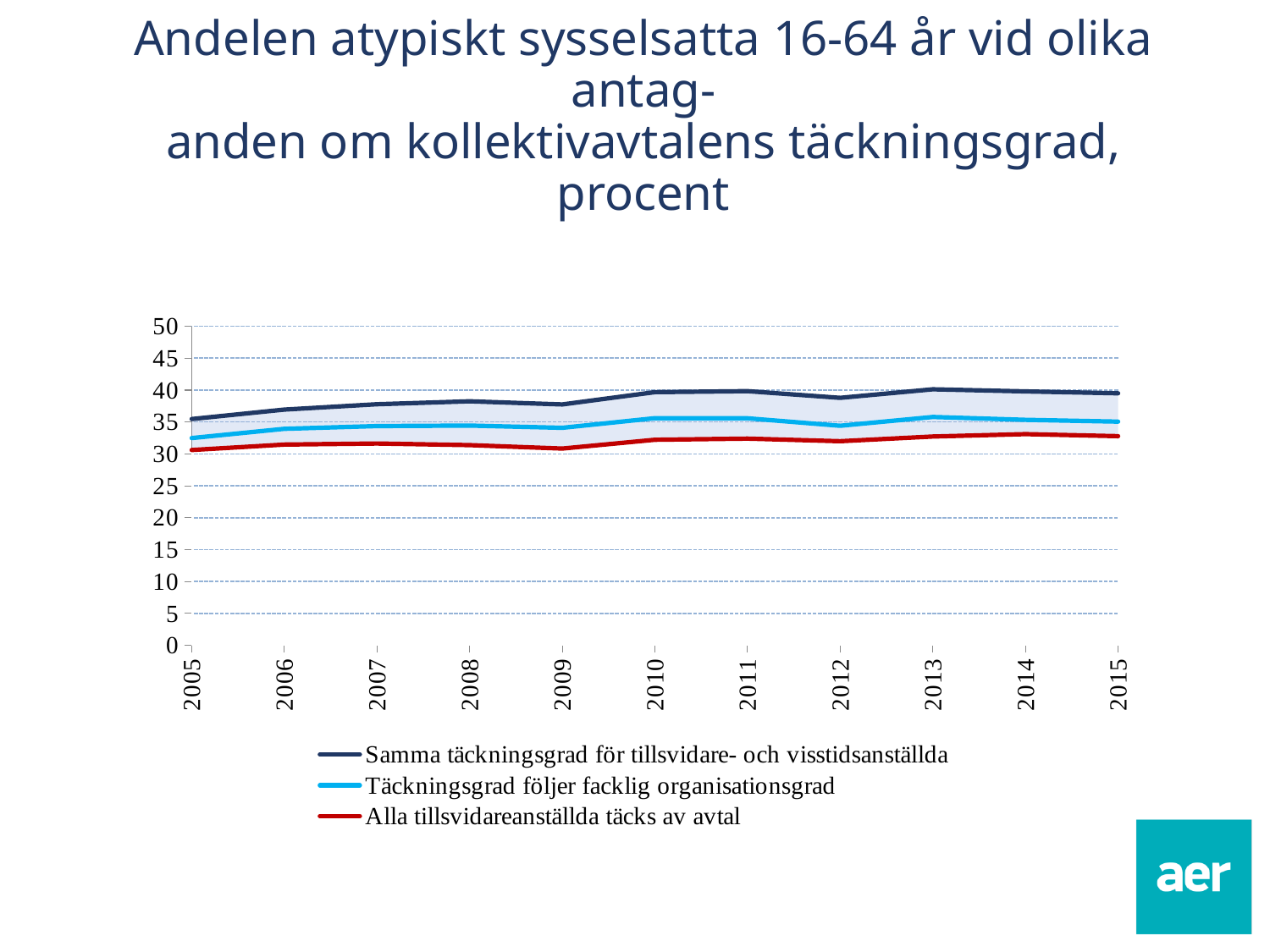
Is the value for 'Samma täckningsgrad för tillsvidare- och visstidsanställda' in 2005 greater or less than 40? less What kind of chart is shown on the slide? line chart How many series does the legend list? 3 Overall, does the 'Samma täckningsgrad för tillsvidare- och visstidsanställda' line rise or fall from 2005 to 2015? rise Is the value for 'Alla tillsvidareanställda täcks av avtal' in 2015 greater or less than 30? greater How many years are shown on the x axis? 11 Is the value for 'Täckningsgrad följer facklig organisationsgrad' in 2005 greater or less than 35? less Which series has the highest values across the chart? Samma täckningsgrad för tillsvidare- och visstidsanställda What colour is the line for 'Alla tillsvidareanställda täcks av avtal'? red Which series has the lowest values across the chart? Alla tillsvidareanställda täcks av avtal